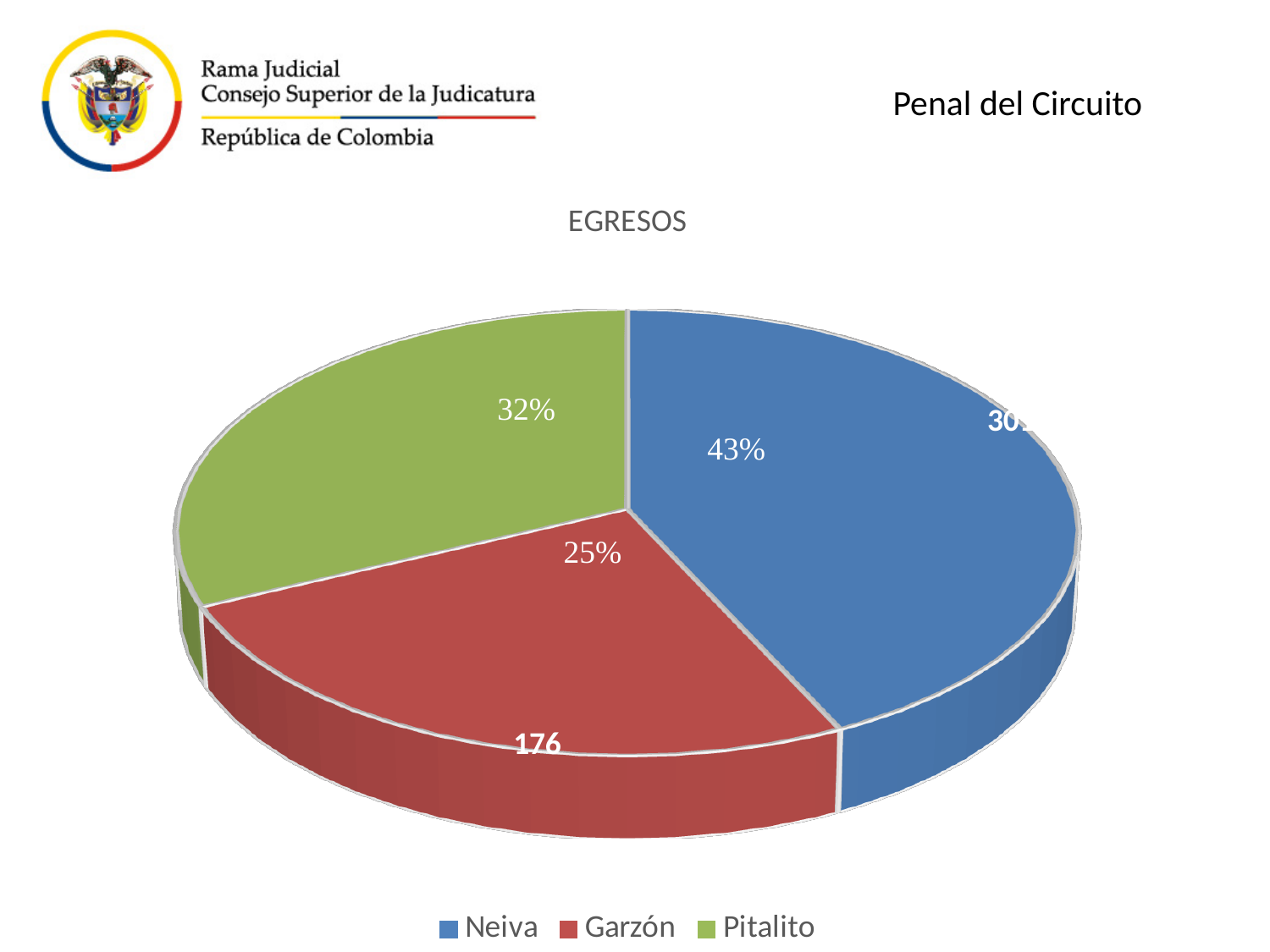
What share of the pie does Garzón represent? 25% Which colour represents Pitalito in the chart? Green Which category has the smallest slice of the pie? Garzón What share of the pie does Pitalito represent? 32% How many categories are shown in the pie chart? 3 Which category has the largest slice of the pie? Neiva Which slice is larger, Neiva or Pitalito? Neiva What share of the pie does Neiva represent? 43% What is the title of the chart? EGRESOS What kind of chart is shown on the slide? Pie chart How many entries does the legend list? 3 Which slice is larger, Pitalito or Garzón? Pitalito